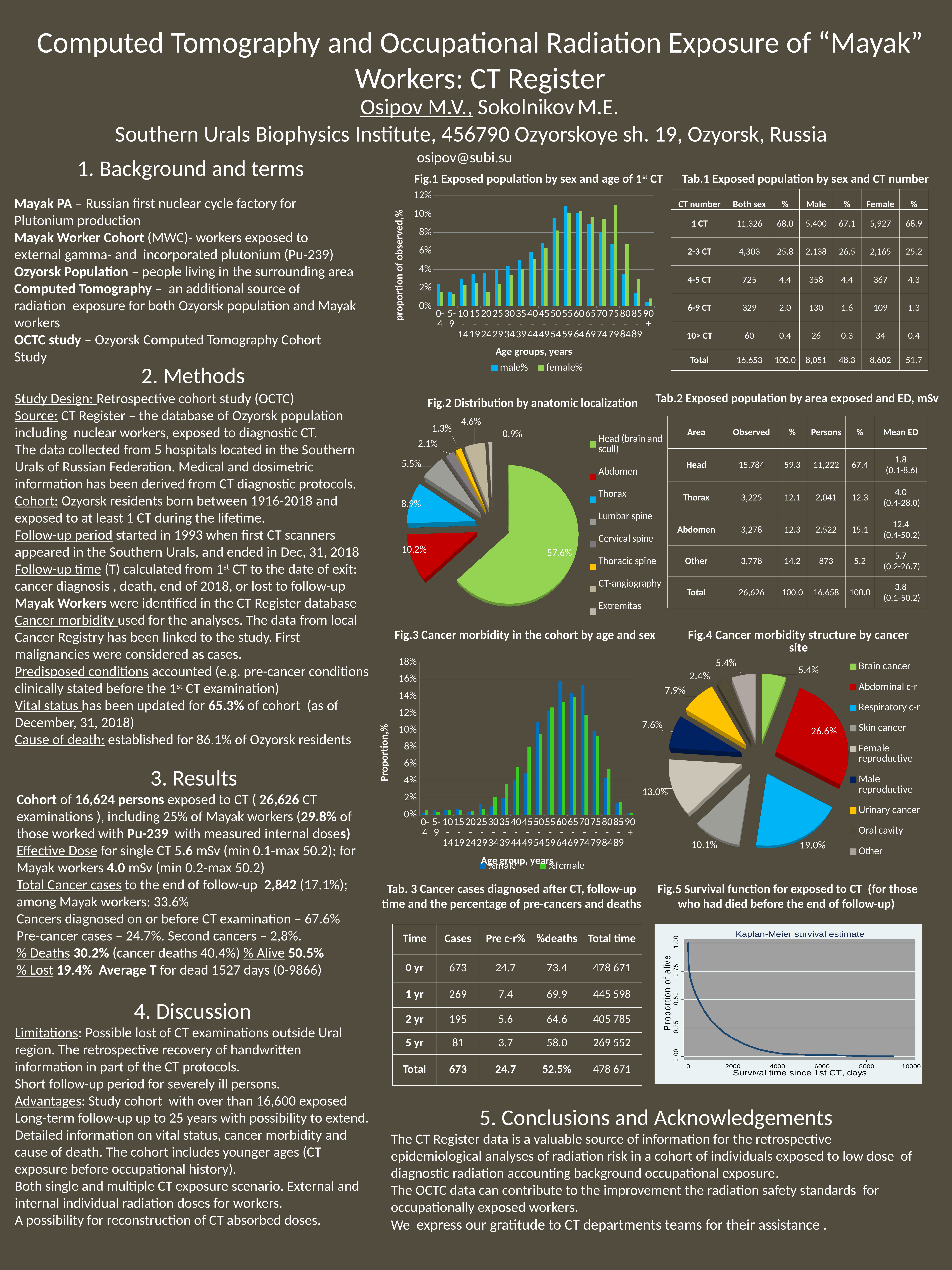
In Fig.2 Distribution by anatomic localization, what is the difference between the Abdomen and Thorax shares? 1.3% In Fig.2 Distribution by anatomic localization, which category has the largest share of the pie? Head (brain and scull) In Fig.4 Cancer morbidity structure by cancer site, what is the difference between the Abdominal c-r and Respiratory c-r shares? 7.6% In Fig.3 Cancer morbidity in the cohort by age and sex, is the %male value for the 60-64 age group greater or less than 14%? greater In Fig.4 Cancer morbidity structure by cancer site, which cancer site has the largest share? Abdominal c-r In Fig.2 Distribution by anatomic localization, how many categories does the legend list? 8 In Fig.4 Cancer morbidity structure by cancer site, what is the share for Respiratory c-r? 19.0% What kind of chart is Fig.1 Exposed population by sex and age of 1st CT? bar chart In Fig.1 Exposed population by sex and age of 1st CT, how many series does the legend list? 2 In Fig.4 Cancer morbidity structure by cancer site, which is larger: Skin cancer or Female reproductive? Female reproductive In Fig.5 Survival function for exposed to CT, do the values rise or fall as survival time increases? fall In Fig.2 Distribution by anatomic localization, what share of the pie is Abdomen? 10.2%